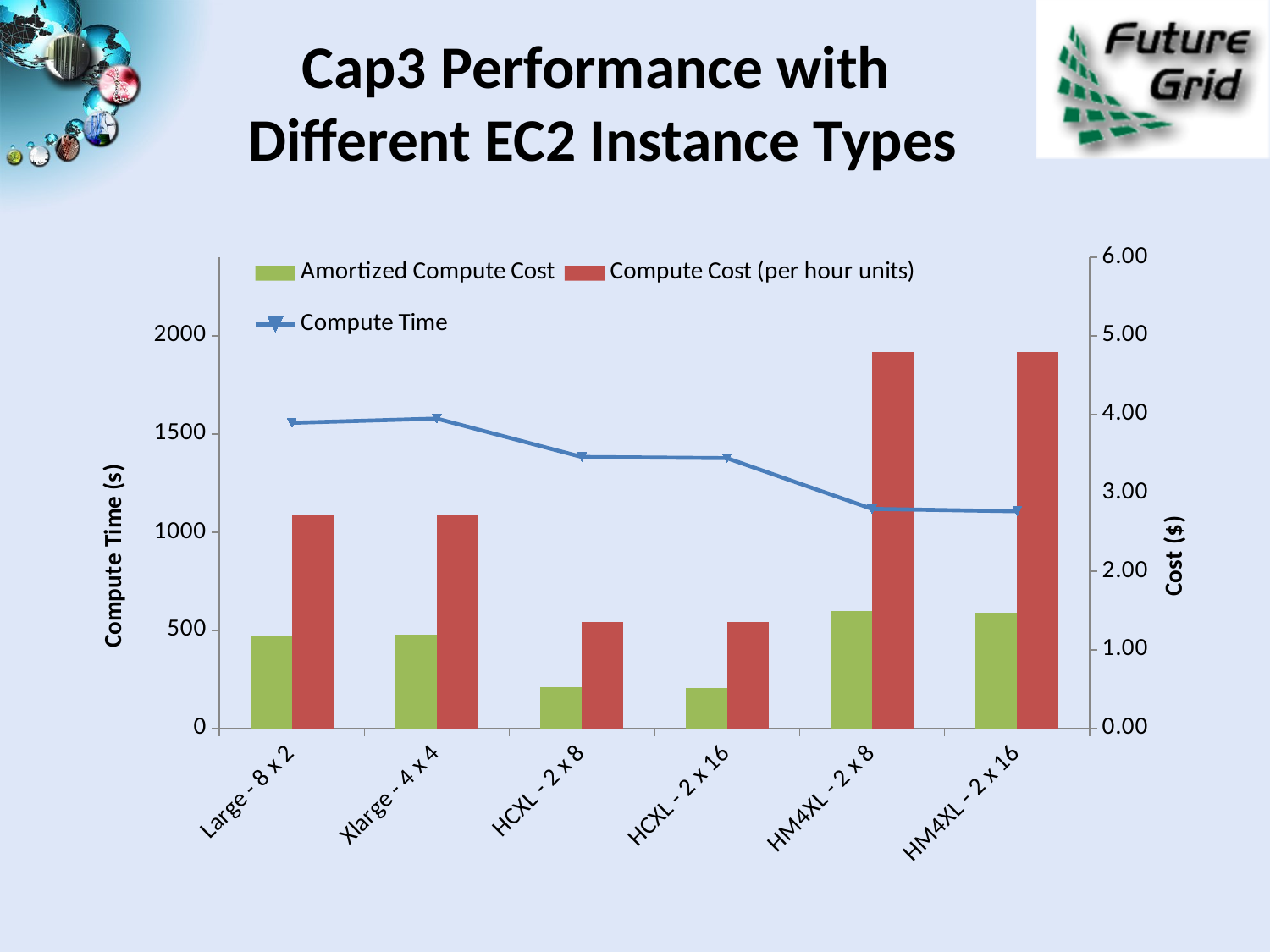
What kind of chart is used to show the Amortized Compute Cost and Compute Cost (per hour units) series? Bar chart Which has the higher Compute Cost (per hour units): HM4XL - 2 x 8 or HCXL - 2 x 8? HM4XL - 2 x 8 Is the Compute Cost (per hour units) for HM4XL - 2 x 8 greater or less than 4.00? greater How many EC2 instance type categories are shown on the x axis of the chart? 6 Does the Compute Time line rise or fall from Large - 8 x 2 to HM4XL - 2 x 16? Fall What is the title of the right-hand vertical axis? Cost ($) Which has the higher Compute Time: Large - 8 x 2 or HM4XL - 2 x 8? Large - 8 x 2 Is the Compute Cost (per hour units) for HCXL - 2 x 8 greater or less than 2.00? less Is the Compute Time for HM4XL - 2 x 16 greater or less than 1500? less How many series does the chart legend list? 3